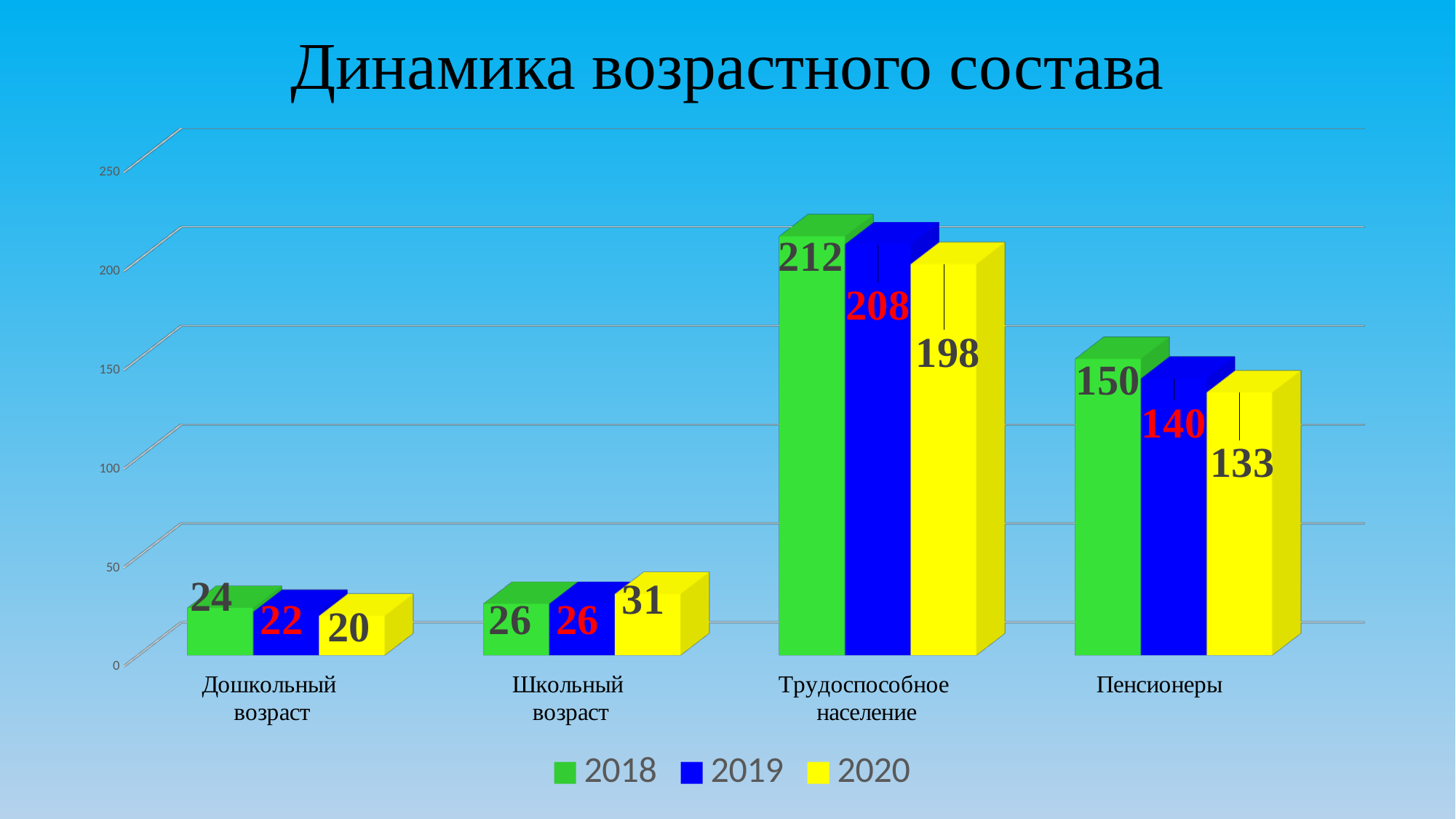
Which category has the highest value in 2019? Трудоспособное население Which category has the lowest value in 2020? Дошкольный возраст Is the 2020 value for Трудоспособное население greater or less than 150? greater How many categories are shown on the x axis? 4 What kind of chart is shown on the slide? Bar chart What is the value for Трудоспособное население in 2018? 212 Which is larger: the 2020 value for Школьный возраст or the 2020 value for Дошкольный возраст? Школьный возраст What is the value for Школьный возраст in 2019? 26 What is the difference between the 2018 and 2020 values for Пенсионеры? 17 What is the value for Пенсионеры in 2020? 133 How many series does the legend list? 3 Do the values for Пенсионеры rise or fall from 2018 to 2020? Fall